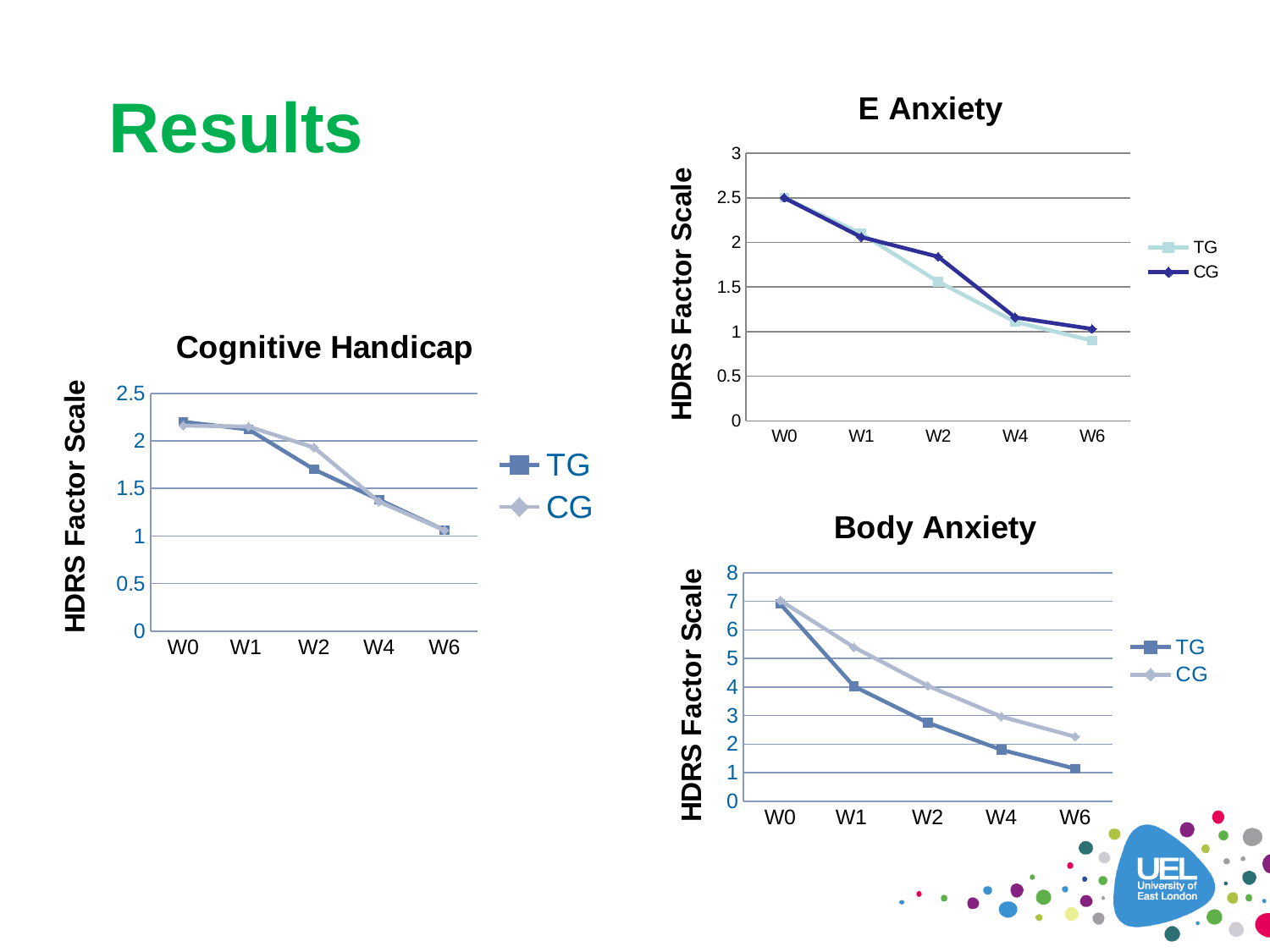
In the E Anxiety chart, is the TG value at W6 greater or less than 1? less How many series does the legend of the Body Anxiety chart list? 2 What kind of chart is the Cognitive Handicap chart? line chart In the E Anxiety chart, which series has the larger value at W2, TG or CG? CG In the Body Anxiety chart, is the CG value at W1 greater or less than 5? greater How many time points are shown on the x axis of the E Anxiety chart? 5 In the Body Anxiety chart, at which time point is the TG value highest? W0 In the Body Anxiety chart, which series has the larger value at W4, TG or CG? CG In the Body Anxiety chart, is the TG value at W2 greater or less than 3? less What is the y-axis label on the E Anxiety chart? HDRS Factor Scale In the Body Anxiety chart, do the TG values rise or fall from W0 to W6? fall